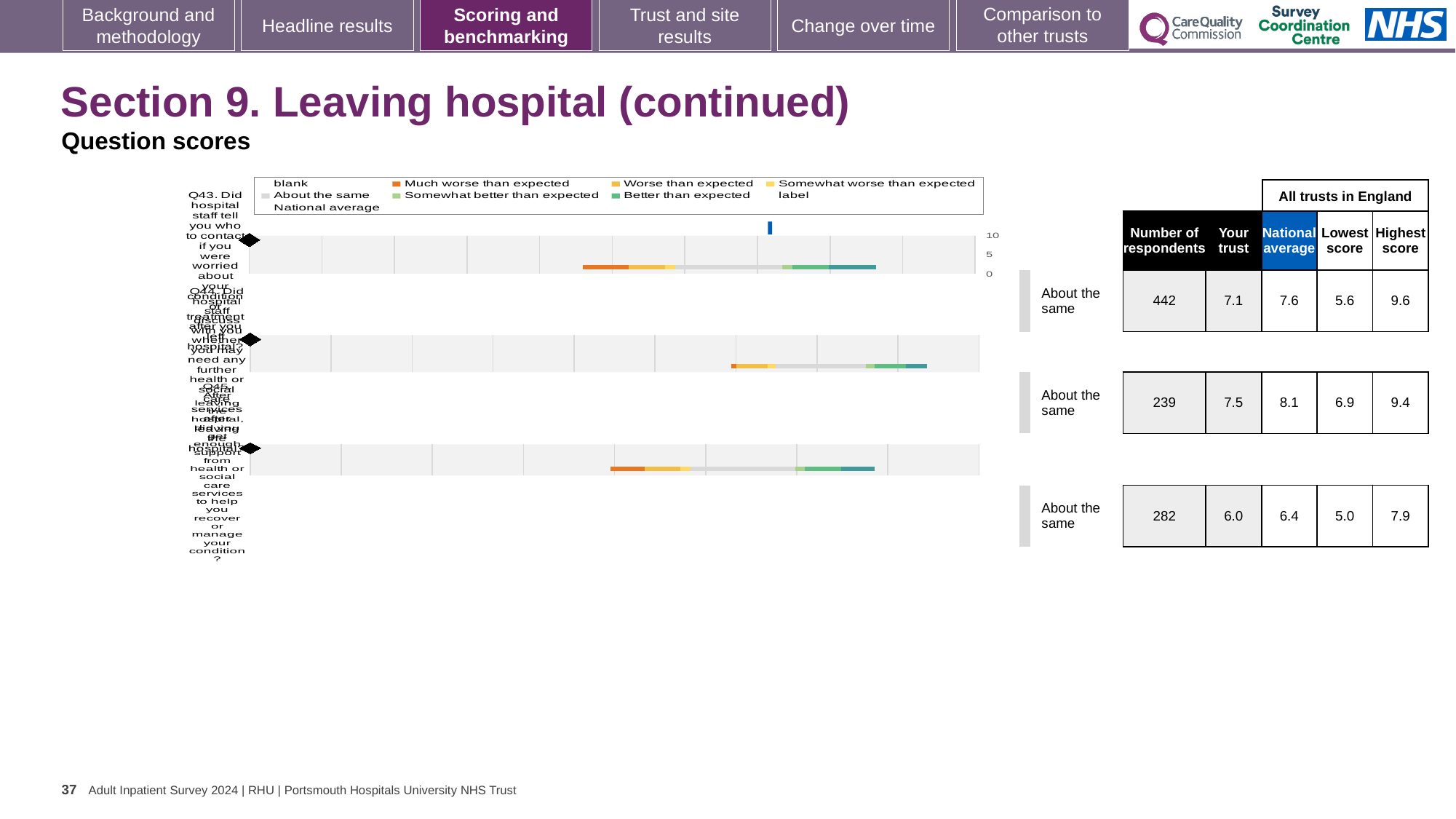
What kind of chart is shown on the slide? bar chart How many question rows (Q43, Q44, Q45) are plotted in the chart? 3 How many respondents are listed for the third row, Q45? 282 What benchmark category is shown next to each of the three question rows? About the same What is the highest score among all trusts in England for Q43? 9.6 What is the 'Your trust' score for the first row, Q43? 7.1 Which question row has the highest 'Your trust' score? Q44 For Q44, which is larger: the 'Your trust' score or the national average? National average For Q45, what is the difference between the highest score and the lowest score among all trusts in England? 2.9 For Q43, what is the difference between the national average and the 'Your trust' score? 0.5 Which question row has the lowest 'Your trust' score? Q45 What is the national average score for the second row, Q44? 8.1